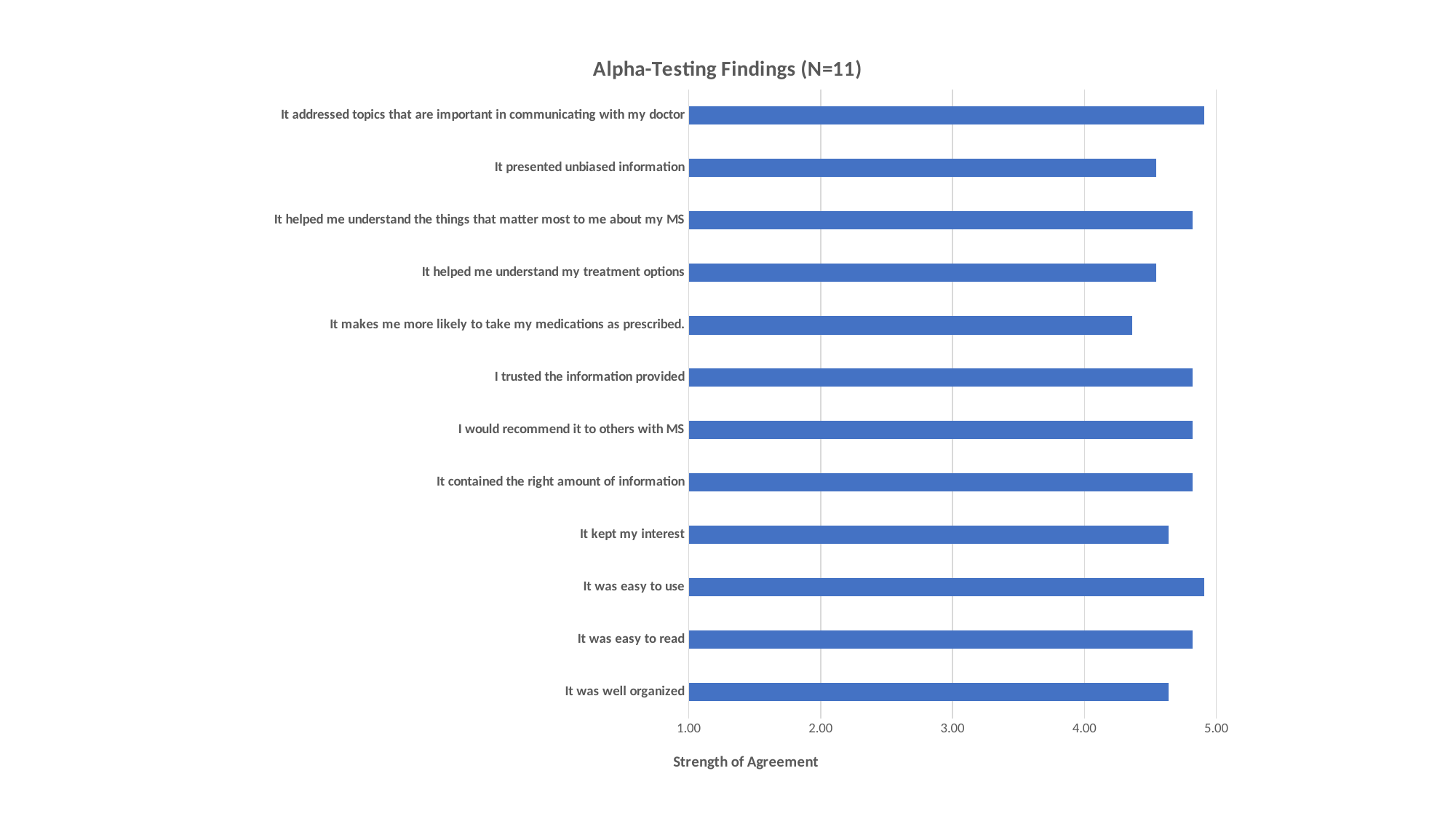
What kind of chart is shown on the slide? Bar chart Is the value for "It was easy to use" greater or less than 5.00? less Is the value for "It makes me more likely to take my medications as prescribed." greater or less than 4.00? greater Which statement has the lowest strength of agreement? It makes me more likely to take my medications as prescribed. Which has a lower strength of agreement: "It presented unbiased information" or "It was easy to read"? It presented unbiased information What is the label on the horizontal axis of the chart? Strength of Agreement Which has a higher strength of agreement: "It kept my interest" or "It was easy to use"? It was easy to use How many statements (categories) are plotted in the chart? 12 Is the value for "It was well organized" greater or less than 3.00? greater What is the title of the chart? Alpha-Testing Findings (N=11) Which has a higher strength of agreement: "It addressed topics that are important in communicating with my doctor" or "It makes me more likely to take my medications as prescribed."? It addressed topics that are important in communicating with my doctor